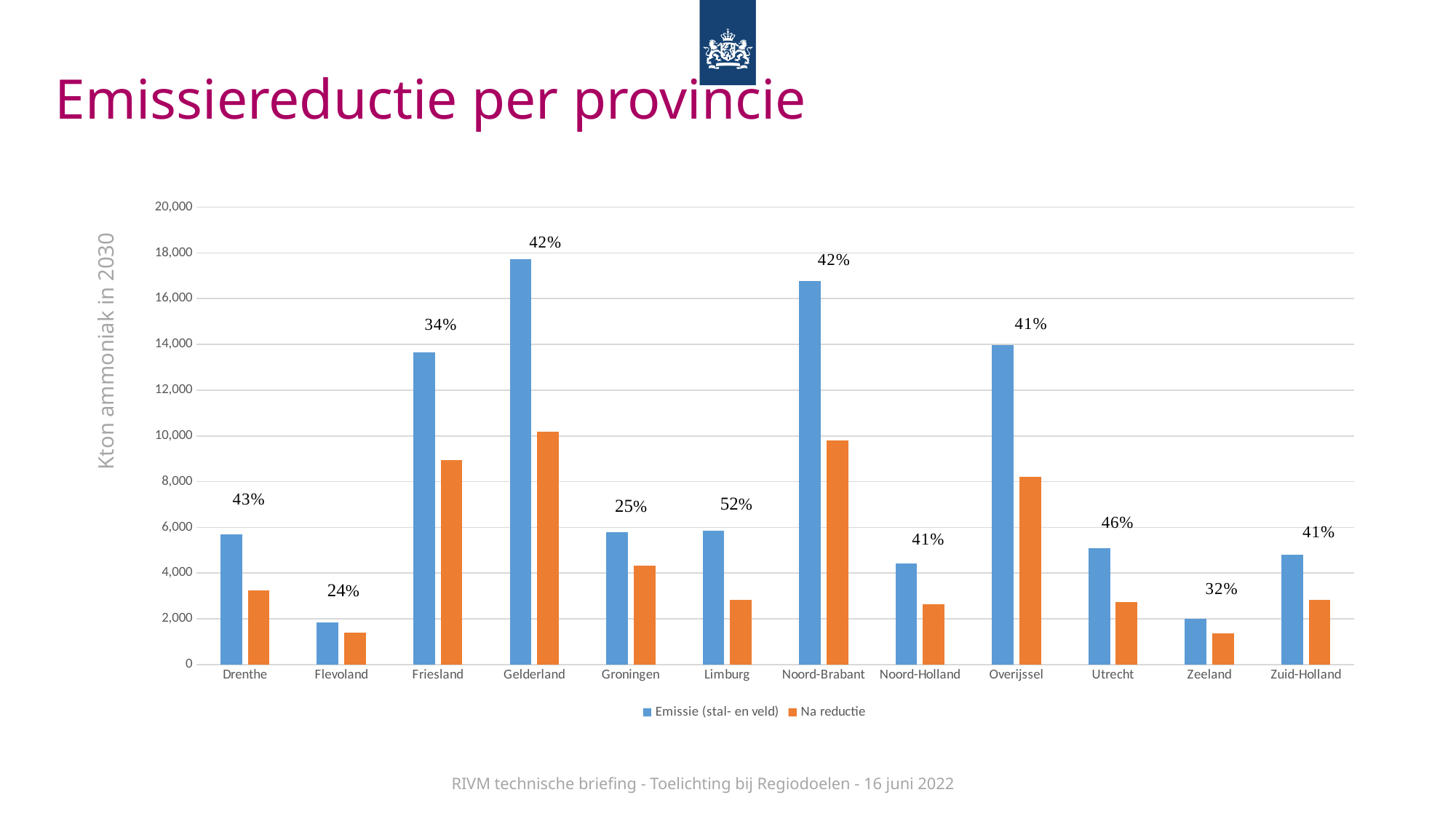
What percentage label is shown above the bars for Flevoland? 24% What is the difference in percentage points between the labels for Utrecht and Zeeland? 14 How many series does the chart's legend list? 2 Which is larger, the 'Na reductie' value for Groningen or for Limburg? Groningen Which province has the highest percentage label in the chart? Limburg How many provinces are shown on the x axis of the chart? 12 Is the 'Emissie (stal- en veld)' value for Noord-Brabant greater or less than 16,000? greater Which province has the lowest percentage label in the chart? Flevoland Which province has the tallest 'Emissie (stal- en veld)' bar? Gelderland What percentage label is shown above the bars for Limburg? 52% What type of chart is shown on the slide? bar chart Is the 'Na reductie' value for Friesland greater or less than 10,000? less